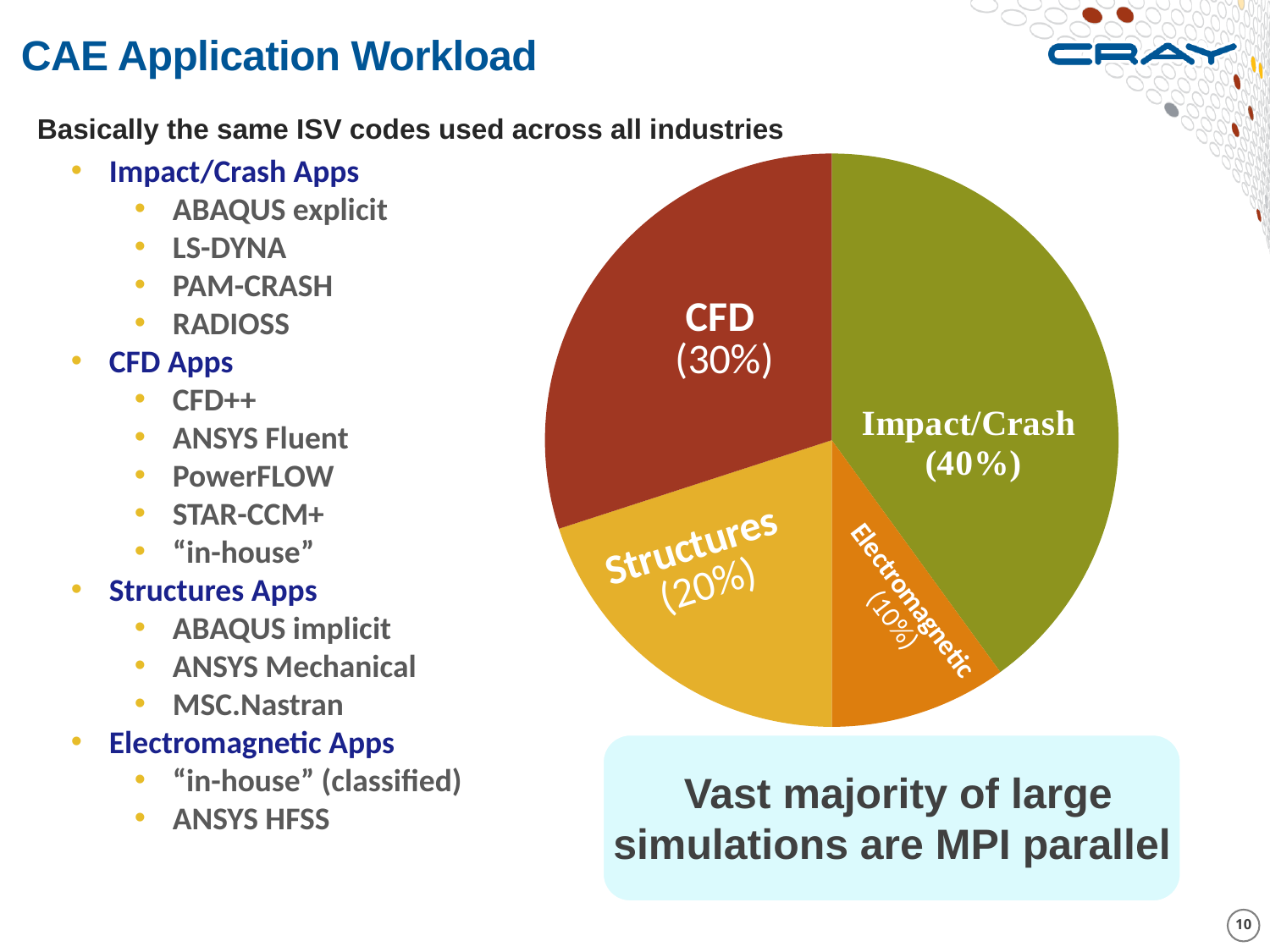
What share of the pie does Impact/Crash have? 40% What share of the pie does Electromagnetic have? 10% How many slices does the pie chart have? 4 Which is larger, the Structures slice or the Electromagnetic slice? Structures Which slice of the pie is the largest? Impact/Crash Which slice of the pie is the smallest? Electromagnetic What share of the pie does CFD have? 30% What is the difference in percentage points between the Impact/Crash and CFD slices? 10% What is the combined share of the CFD and Structures slices? 50% What colour is the Impact/Crash slice? green What kind of chart is shown on the slide? pie chart